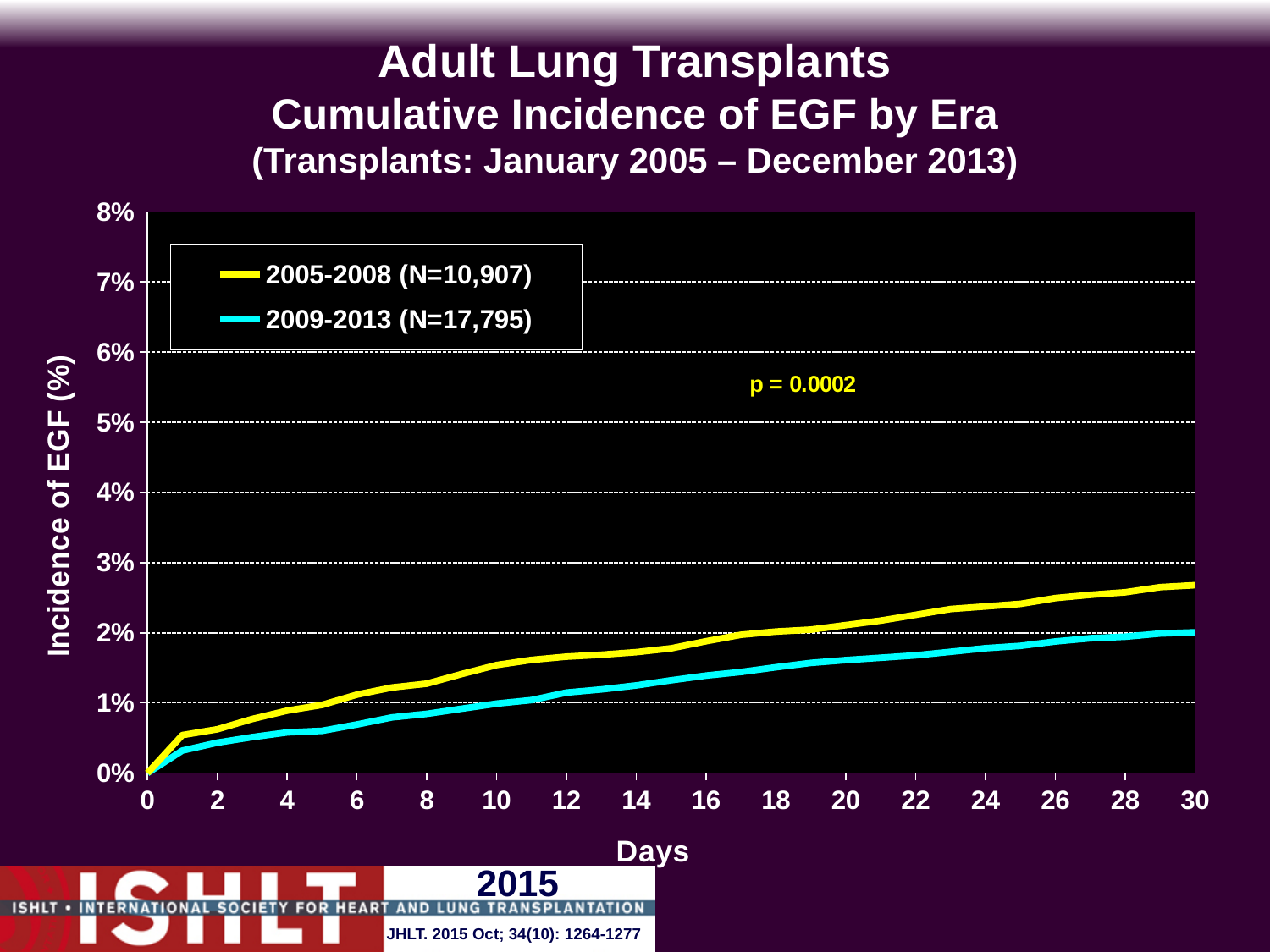
How many series does the legend list? 2 Which era has the higher cumulative incidence of EGF at day 30? 2005-2008 Does the cumulative incidence of EGF for 2005-2008 rise or fall as days increase? rise Which series has the lower cumulative incidence of EGF across the 30 days? 2009-2013 Is the value for 2009-2013 at day 30 greater or less than 3%? less Is the value for 2009-2013 at day 20 greater or less than 2%? less What is the N for the 2005-2008 era shown in the legend? N=10,907 Is the value for 2005-2008 at day 30 greater or less than 2%? greater What p-value is shown on the chart? p = 0.0002 What kind of chart is shown on the slide? line chart Does the cumulative incidence of EGF for 2009-2013 rise or fall along the x axis? rise